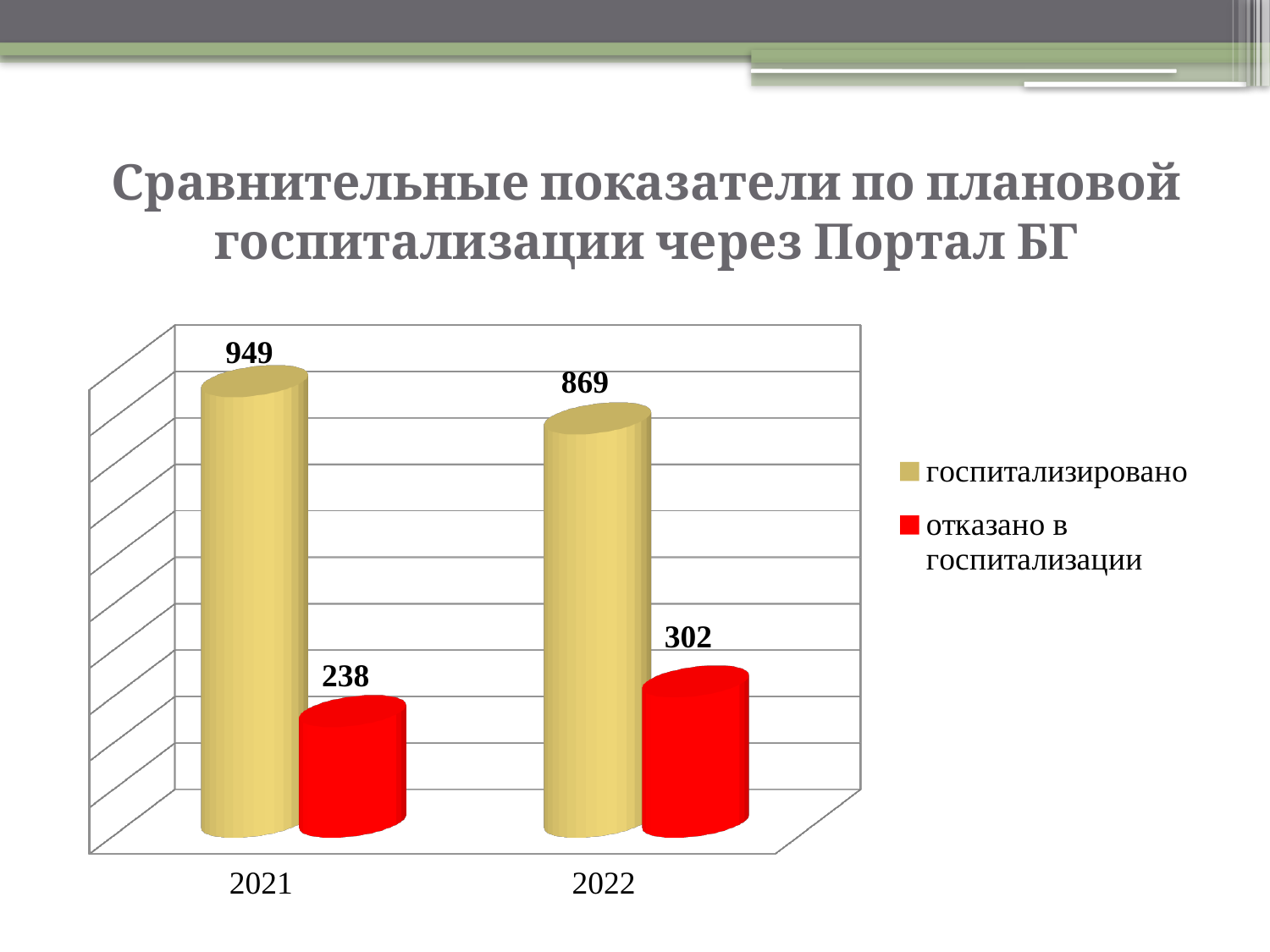
In which year was the number of refusals of hospitalization lowest? 2021 What type of chart is shown on the slide? Bar chart In which year was the number of hospitalized patients higher? 2021 Which is larger: the number hospitalized in 2022 or the number refused in 2022? Hospitalized in 2022 (869) What is the difference between the number hospitalized in 2021 and in 2022? 80 How many years (categories) are shown on the x axis? 2 How many patients were refused hospitalization (отказано в госпитализации) in 2022? 302 How many patients were refused hospitalization (отказано в госпитализации) in 2021? 238 How many patients were hospitalized (госпитализировано) in 2021? 949 How many series does the legend list? 2 How many patients were hospitalized (госпитализировано) in 2022? 869 By how much did the number of refusals of hospitalization increase from 2021 to 2022? 64